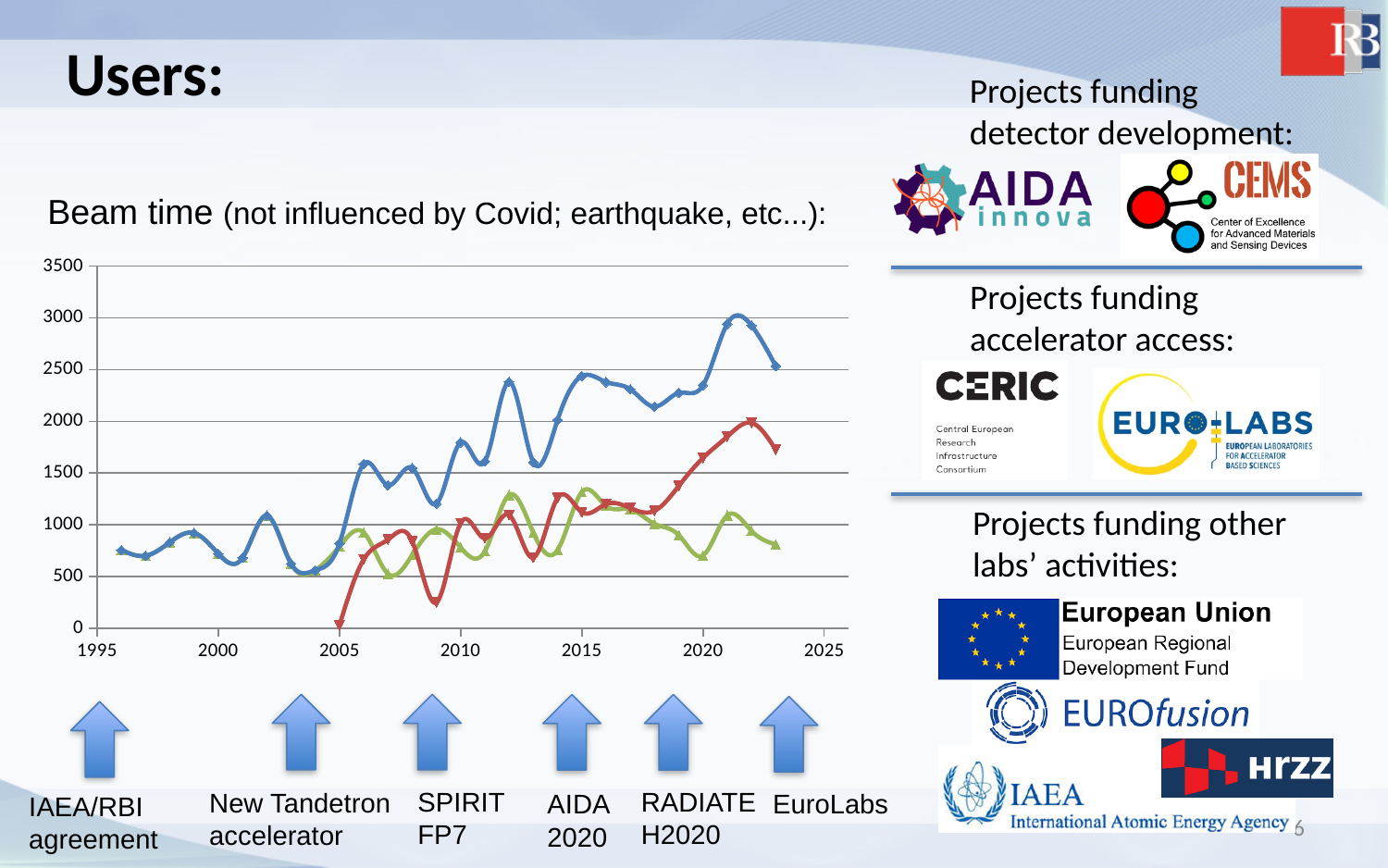
At 2021, which line has the larger value, the red line or the green line? the red line What kind of chart is shown on the slide? line chart Which line reaches the highest value on the chart? the blue line Is the value of the red line at 2005 greater or less than 500? less Is the value of the blue line at 1996 greater or less than 1000? less Is the value of the green line at 2023 greater or less than 1000? less At 2023, which line has the larger value, the blue line or the red line? the blue line Does the blue line overall rise or fall between 1995 and 2021? rise What is the highest value shown on the chart's vertical axis? 3500 How many lines are plotted on the chart? 3